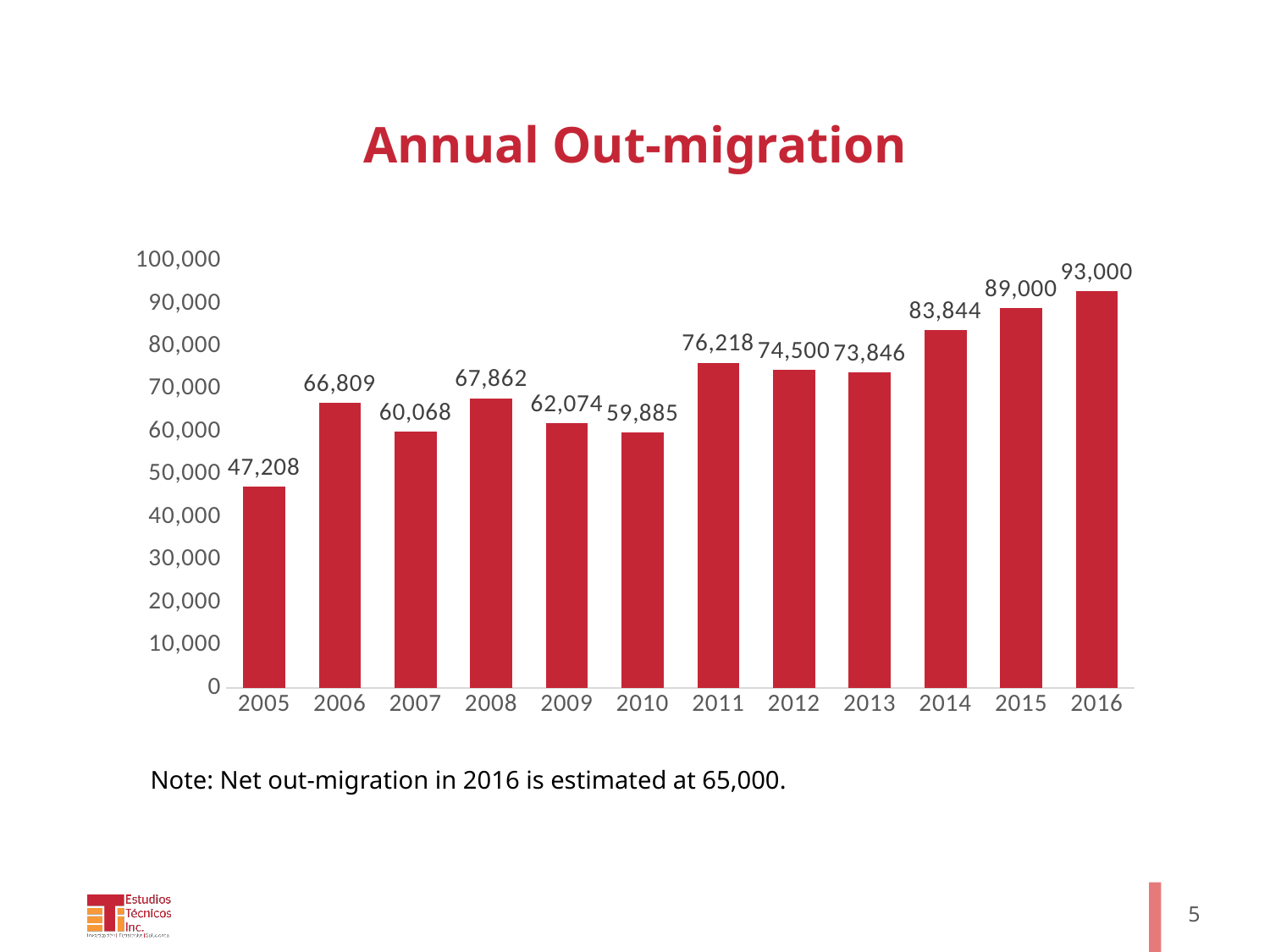
What is the annual out-migration value for 2011? 76,218 Which year has the highest annual out-migration? 2016 What is the annual out-migration value for 2014? 83,844 What is the difference between the 2016 and 2005 out-migration values? 45,792 What is the annual out-migration value for 2005? 47,208 Which year has the lowest annual out-migration? 2005 Is the out-migration value for 2005 greater or less than 50,000? less How many years are shown on the x axis of the chart? 12 What is the difference between the 2015 and 2014 out-migration values? 5,156 What kind of chart is shown on the slide? bar chart Overall, do the out-migration values rise or fall from 2005 to 2016? rise Which year has the larger out-migration value, 2011 or 2014? 2014